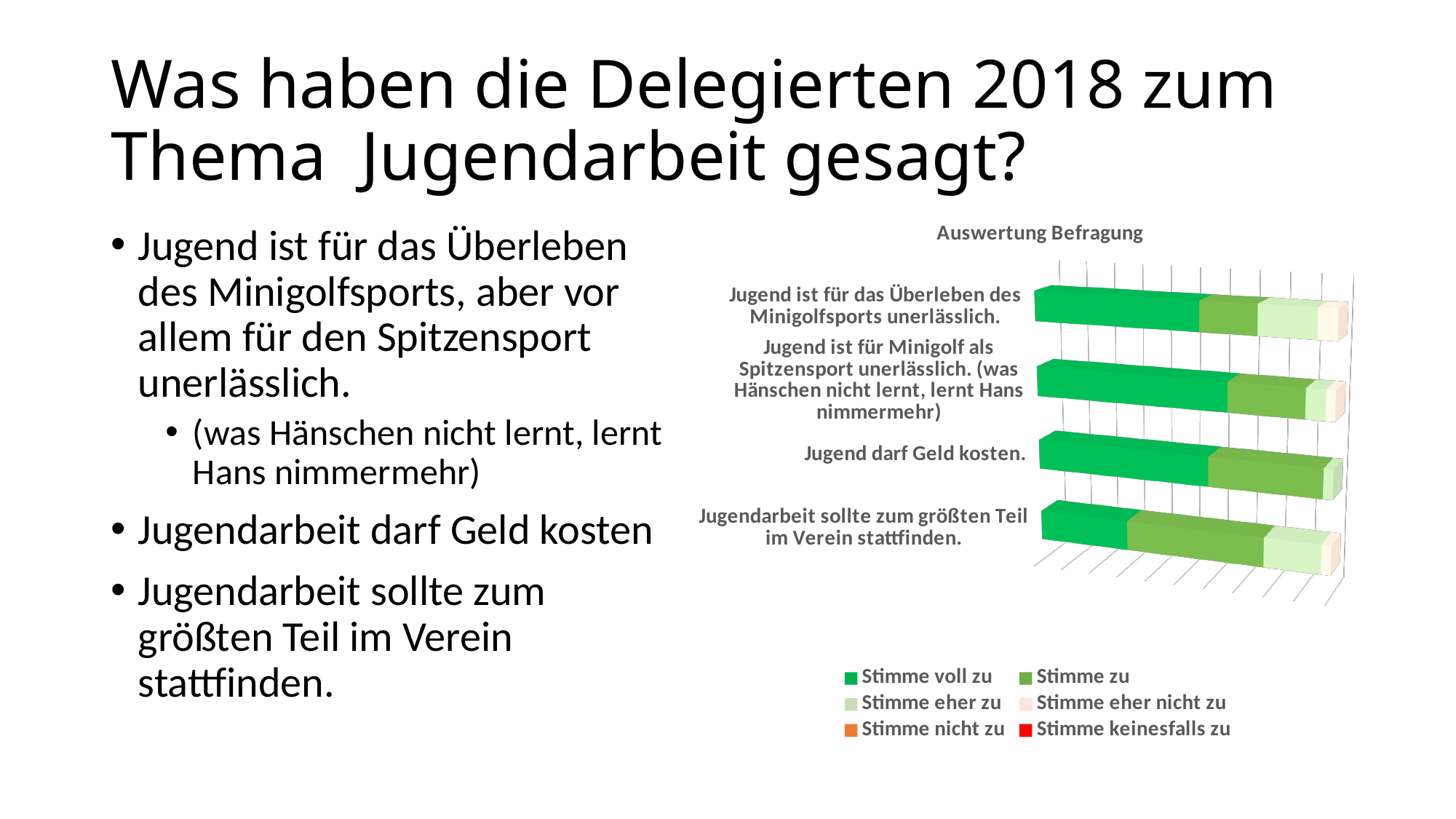
Which statement has the longest 'Stimme zu' segment? Jugendarbeit sollte zum größten Teil im Verein stattfinden. How many series does the chart legend list? 6 Which legend entry is shown in red? Stimme keinesfalls zu How many statements (categories) are plotted in the chart? 4 Which statement has the shortest 'Stimme voll zu' segment? Jugendarbeit sollte zum größten Teil im Verein stattfinden. What kind of chart is shown on the slide? Stacked bar chart What is the title of the chart on the slide? Auswertung Befragung Which has the larger 'Stimme voll zu' segment: 'Jugend darf Geld kosten.' or 'Jugendarbeit sollte zum größten Teil im Verein stattfinden.'? Jugend darf Geld kosten. Which has the larger 'Stimme zu' segment: 'Jugend ist für das Überleben des Minigolfsports unerlässlich.' or 'Jugendarbeit sollte zum größten Teil im Verein stattfinden.'? Jugendarbeit sollte zum größten Teil im Verein stattfinden. Which statement has the shortest 'Stimme eher zu' segment? Jugend darf Geld kosten.